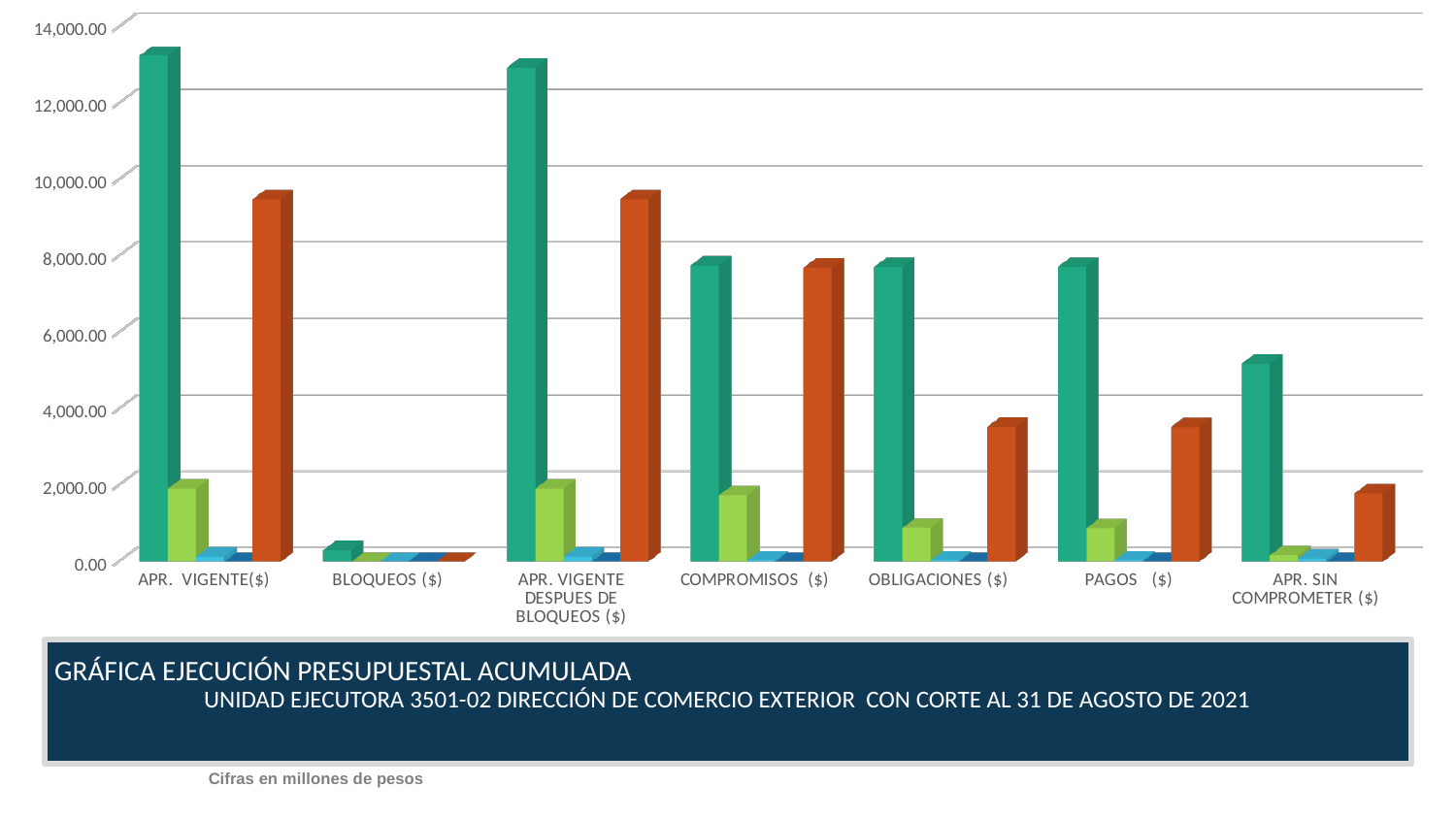
What kind of chart is shown on the slide? Bar chart According to the note below the chart, in what units are the figures expressed? Millones de pesos Is the light green bar for APR. VIGENTE($) greater or less than 4,000.00? less How many categories are shown along the x axis of the chart? 7 Is the teal bar for APR. SIN COMPROMETER ($) greater or less than 4,000.00? greater Is the teal bar for APR. VIGENTE($) greater or less than 12,000.00? greater Which is larger in the APR. SIN COMPROMETER ($) category: the teal bar or the light green bar? The teal bar Which is larger: the orange bar for APR. VIGENTE($) or the orange bar for OBLIGACIONES ($)? APR. VIGENTE($) Which category has the tallest teal bar? APR. VIGENTE($) Which category has the shortest teal bar? BLOQUEOS ($)